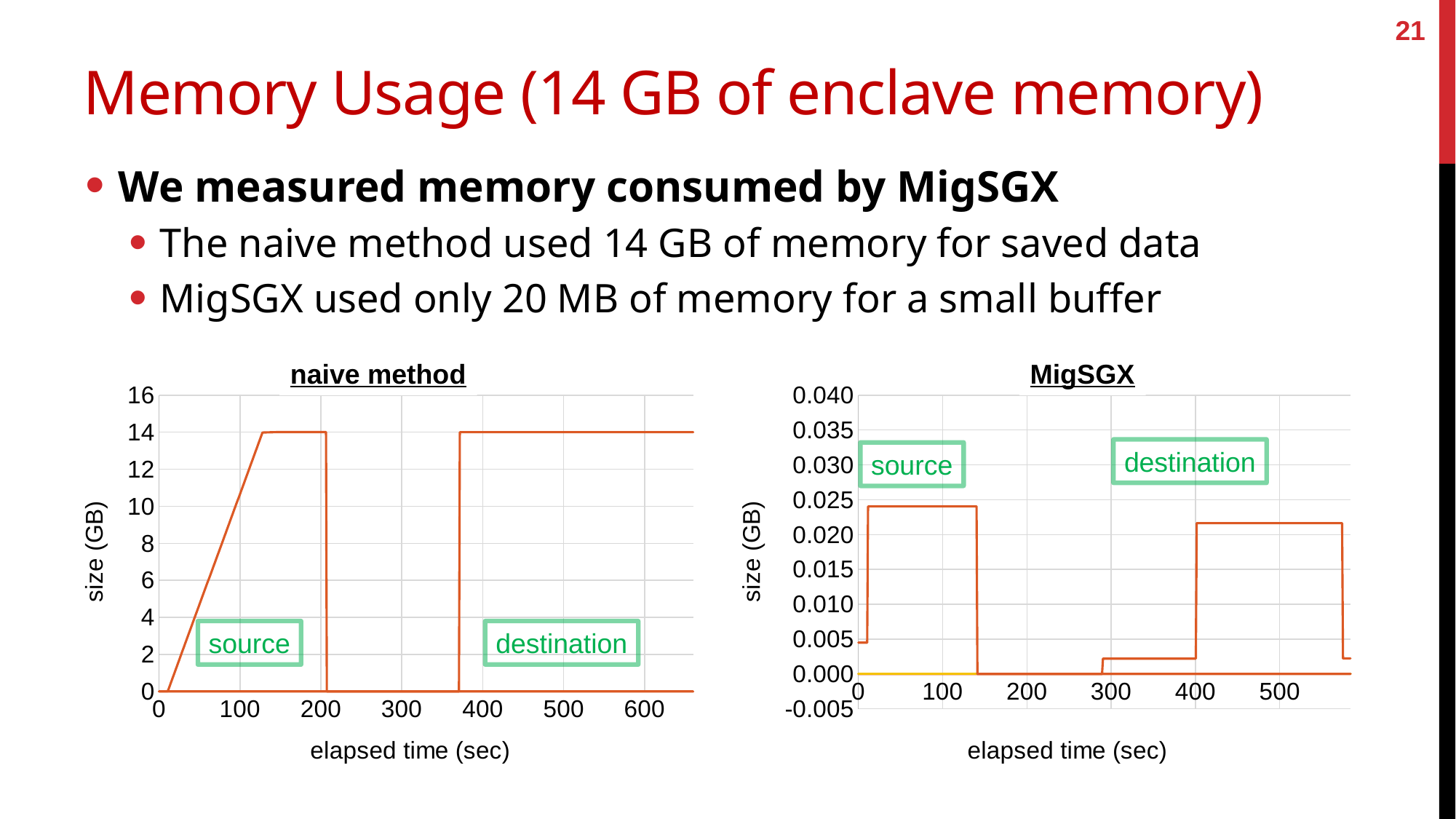
In the "naive method" chart, what is the plateau memory size for the destination? 14 GB In the "naive method" chart, what is the peak memory size reached by the source? 14 GB In the "MigSGX" chart, is the destination plateau value greater or less than 0.025 GB? less In the "naive method" chart, what is the label of the y axis? size (GB) In the "MigSGX" chart, is the source plateau value greater or less than 0.020 GB? greater In the "MigSGX" chart, what is the label of the x axis? elapsed time (sec) In the "MigSGX" chart, which plateau is higher, source or destination? source In the "naive method" chart, does the source memory size rise or fall between 0 and 100 seconds? rise In the "MigSGX" chart, is the source plateau value greater or less than 0.030 GB? less What kind of chart is the "naive method" chart? line chart What kind of chart is the "MigSGX" chart? line chart In the "naive method" chart, what is the highest value shown on the y axis? 16